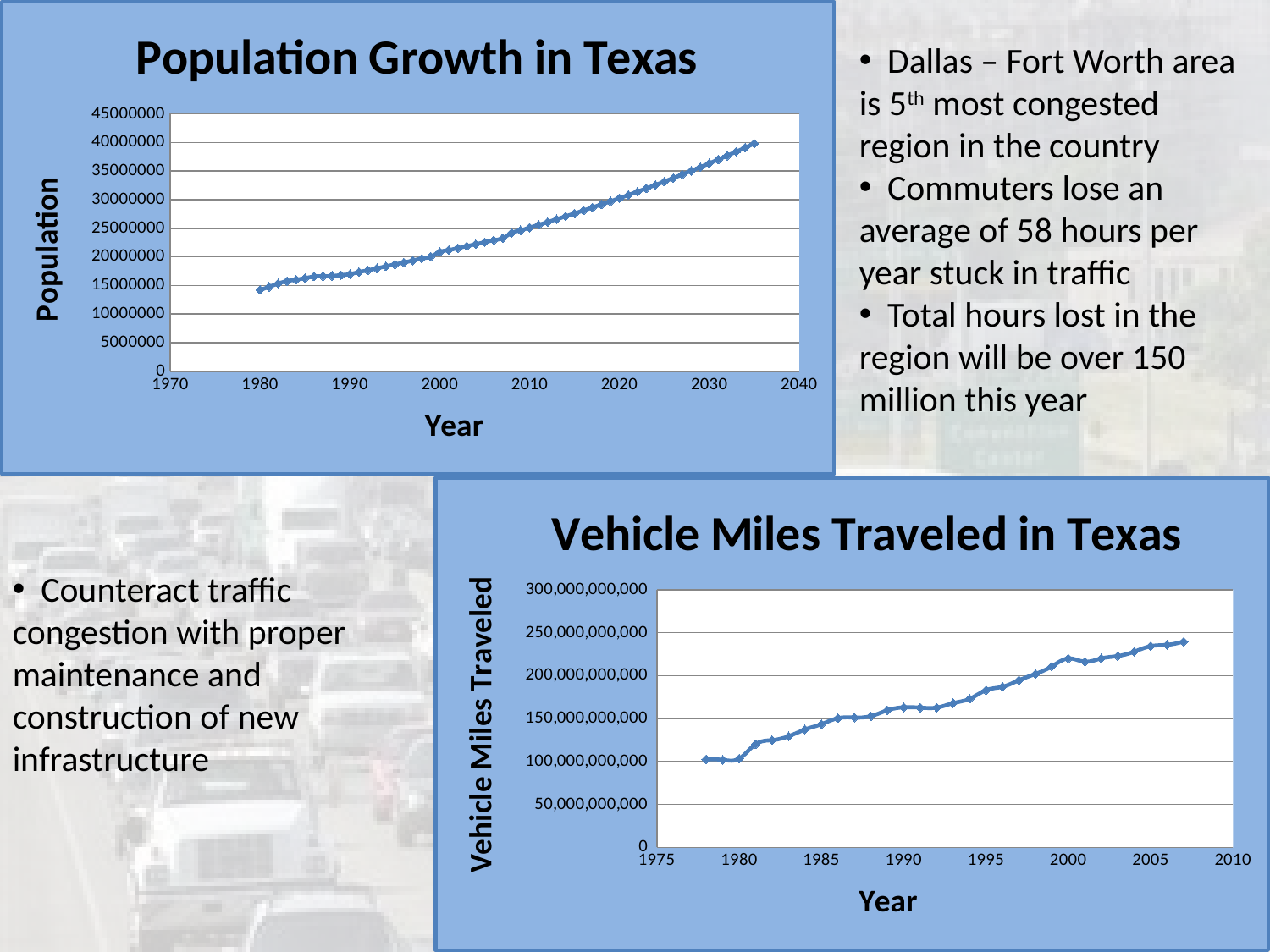
In the 'Population Growth in Texas' chart, is the population for 2035 greater or less than 35000000? greater What is the y-axis title of the 'Vehicle Miles Traveled in Texas' chart? Vehicle Miles Traveled In the 'Population Growth in Texas' chart, is the population for 1990 greater or less than 15000000? greater In the 'Vehicle Miles Traveled in Texas' chart, is the value for 1978 greater or less than 150,000,000,000? less In the 'Vehicle Miles Traveled in Texas' chart, do the values generally rise or fall from 1978 to 2007? rise What kind of chart is the 'Vehicle Miles Traveled in Texas' chart? line chart In the 'Population Growth in Texas' chart, do the values rise or fall as the year increases? rise What kind of chart is the 'Population Growth in Texas' chart? line chart